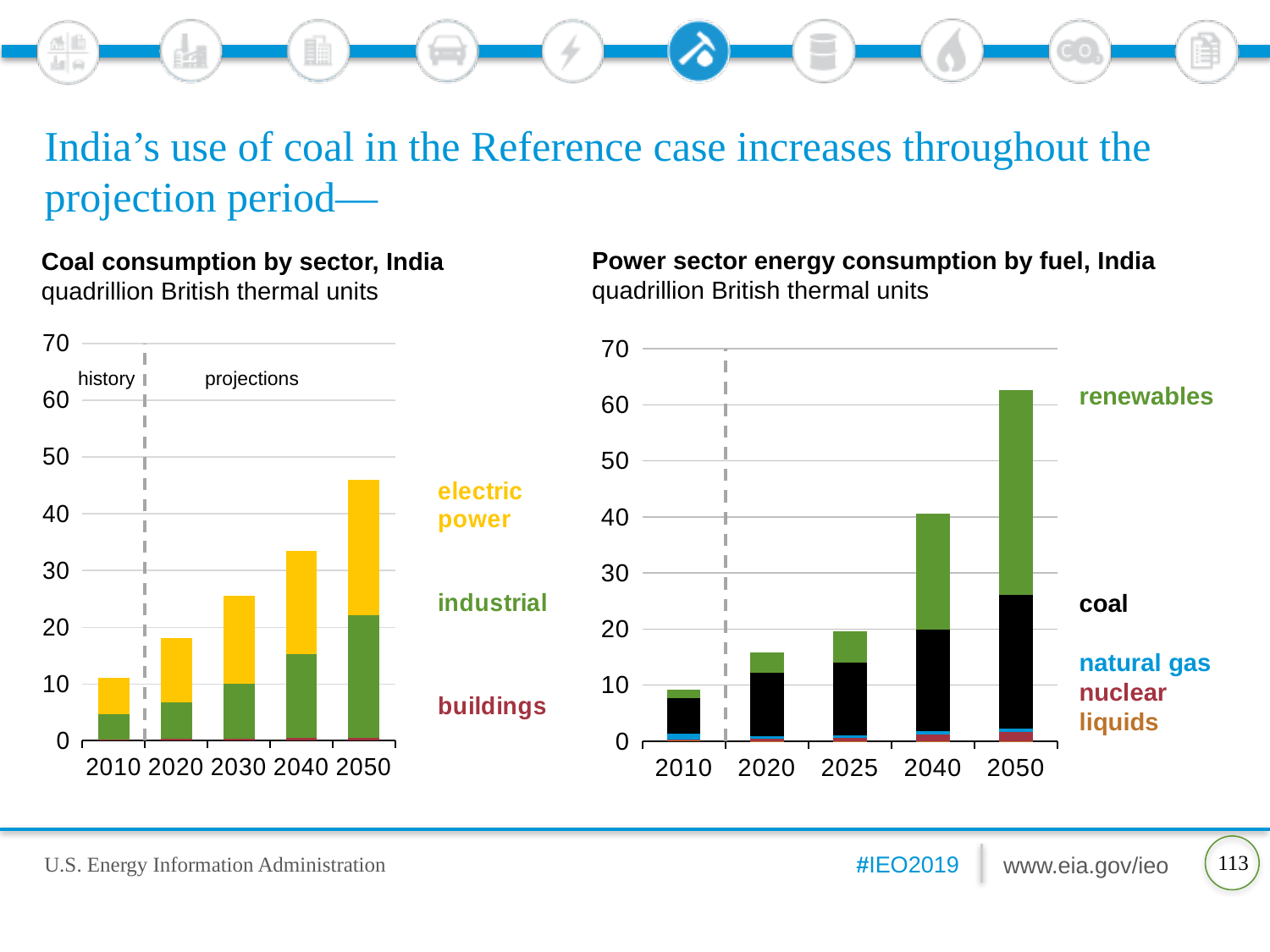
What kind of chart is the 'Power sector energy consumption by fuel, India' chart? stacked bar chart In the 'Coal consumption by sector, India' chart, is the total bar for 2040 greater or less than 30? greater In the 'Coal consumption by sector, India' chart, do total values rise or fall from 2010 to 2050? rise In the 'Power sector energy consumption by fuel, India' chart, is the total bar for 2020 greater or less than 10? greater In the 'Coal consumption by sector, India' chart, how many sectors does the legend list? 3 In the 'Power sector energy consumption by fuel, India' chart, is the total bar for 2050 greater or less than 60? greater In the 'Power sector energy consumption by fuel, India' chart, which year has the highest total consumption? 2050 In the 'Coal consumption by sector, India' chart, which year has the lowest total coal consumption? 2010 In the 'Power sector energy consumption by fuel, India' chart, how many fuels does the legend list? 5 In the 'Coal consumption by sector, India' chart, how many years are shown on the x axis? 5 In the 'Coal consumption by sector, India' chart, which year has the highest total coal consumption? 2050